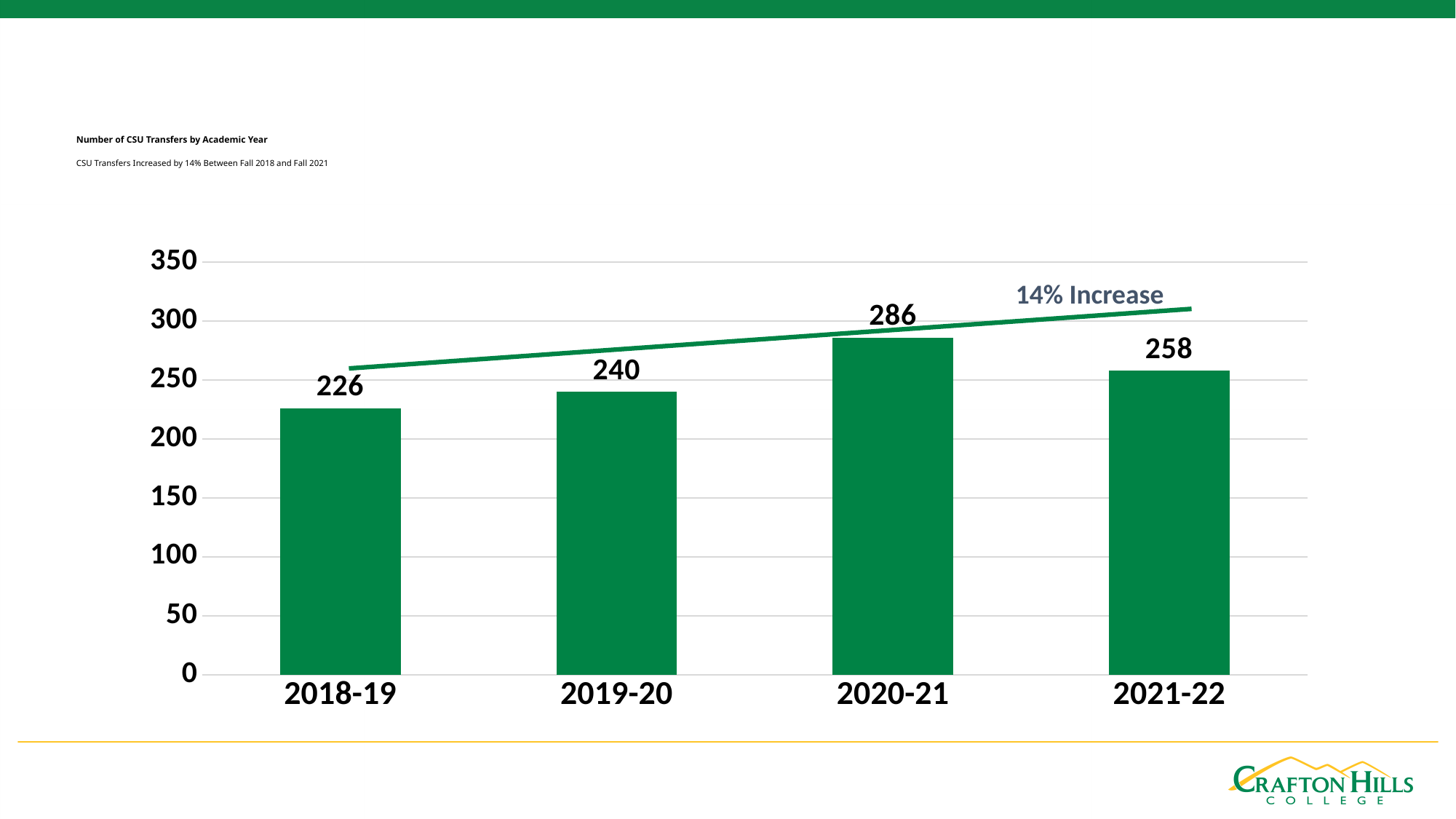
What is the number of CSU transfers for 2020-21? 286 Is the value for 2019-20 greater or less than 250? less What is the difference in CSU transfers between 2020-21 and 2019-20? 46 Which has more CSU transfers, 2019-20 or 2021-22? 2021-22 What is the number of CSU transfers for 2018-19? 226 How many academic years are shown in the chart? 4 What kind of chart is shown on the slide? bar chart What is the number of CSU transfers for 2021-22? 258 What is the difference in CSU transfers between 2021-22 and 2018-19? 32 What percentage increase does the trend line annotation on the chart state? 14% Increase Which academic year has the highest number of CSU transfers? 2020-21 Which academic year has the lowest number of CSU transfers? 2018-19